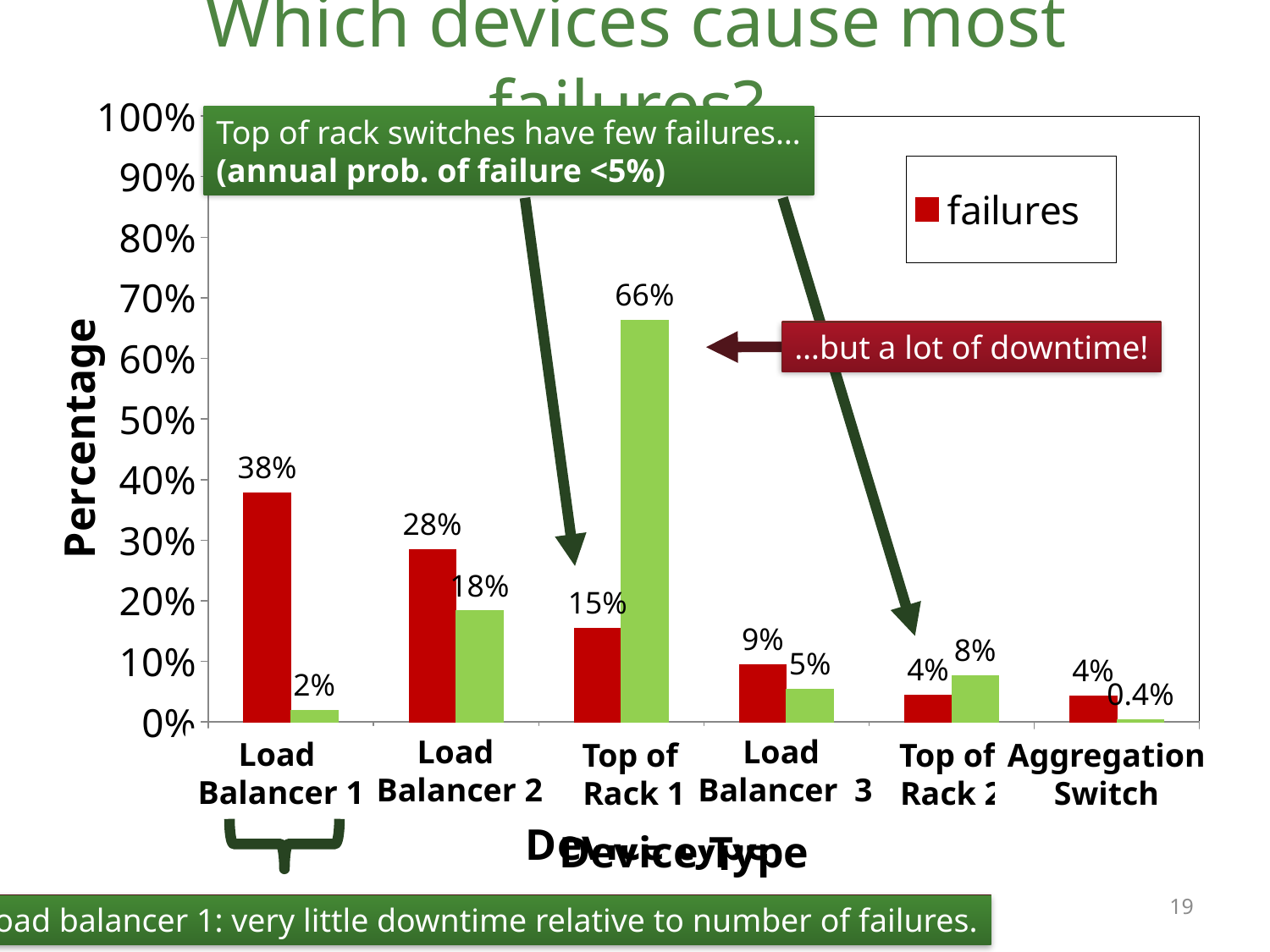
Which device type has the highest green bar? Top of Rack 1 Which device type has the highest failures value? Load Balancer 1 What is the failures value for Load Balancer 1? 38% What is the difference between the failures value and the green bar value for Load Balancer 2? 10 percentage points Is the failures value for Load Balancer 3 greater or less than 10%? less How many device types are shown on the x axis? 6 Do the failures values rise or fall from Load Balancer 1 to Aggregation Switch? fall What is the value of the green bar for Aggregation Switch? 0.4% For Top of Rack 1, which is larger: the failures bar or the green bar? the green bar Which device type has the lowest green bar? Aggregation Switch What is the value of the green bar for Top of Rack 1? 66% What kind of chart is shown on the slide? bar chart